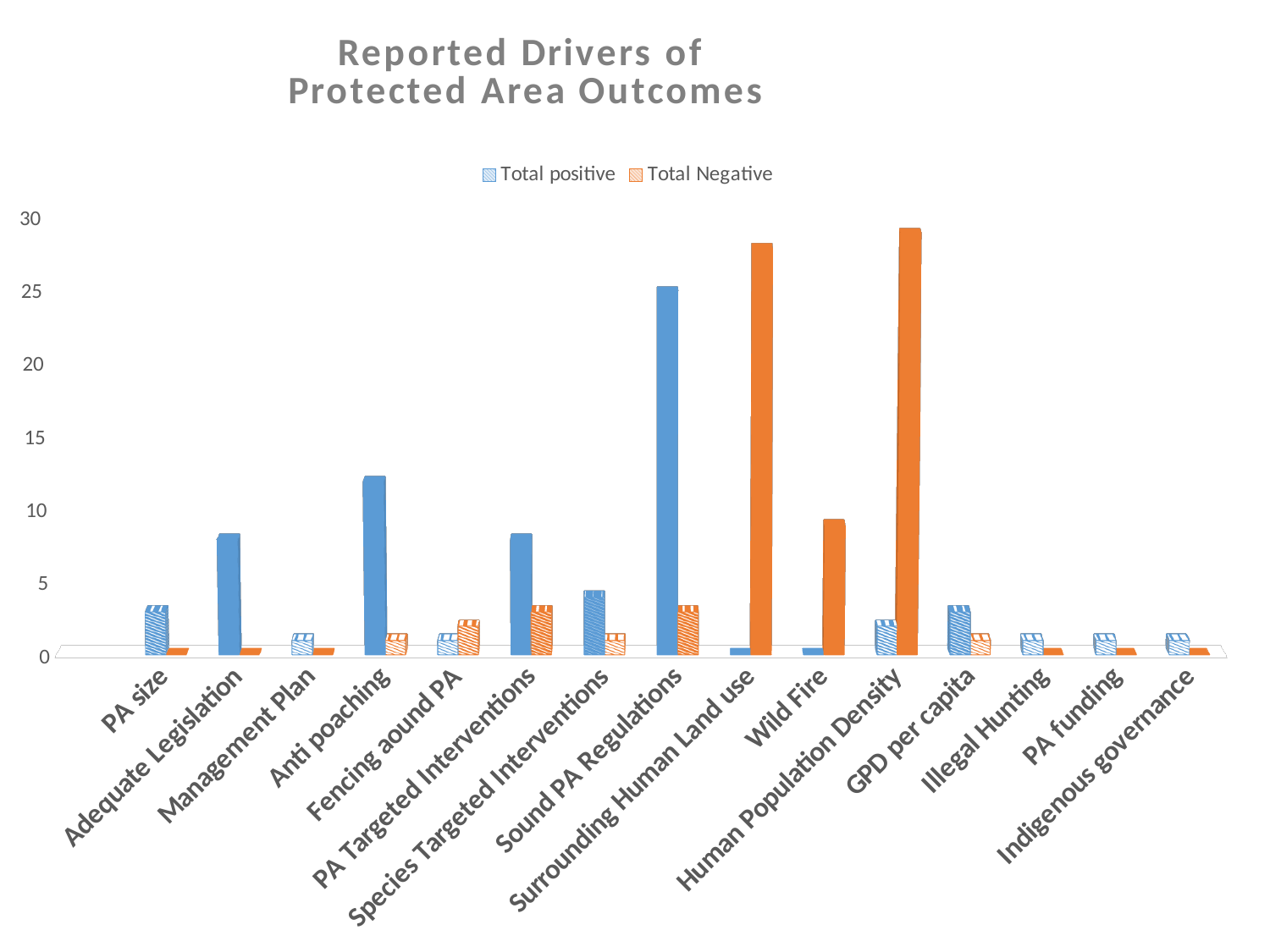
Which is larger: the Total Negative value for Wild Fire or the Total positive value for Sound PA Regulations? Sound PA Regulations Is the Total positive value for Sound PA Regulations greater or less than 20? greater Is the Total positive value for Anti poaching greater or less than 10? greater Is the Total Negative value for Wild Fire greater or less than 10? less Which category has the highest Total Negative value? Human Population Density Which is larger: the Total positive value for Anti poaching or the Total positive value for Adequate Legislation? Anti poaching How many categories are shown on the x axis? 15 What is the title of the chart? Reported Drivers of Protected Area Outcomes How many series does the legend list? 2 What kind of chart is shown on the slide? bar chart Which category has the highest Total positive value? Sound PA Regulations